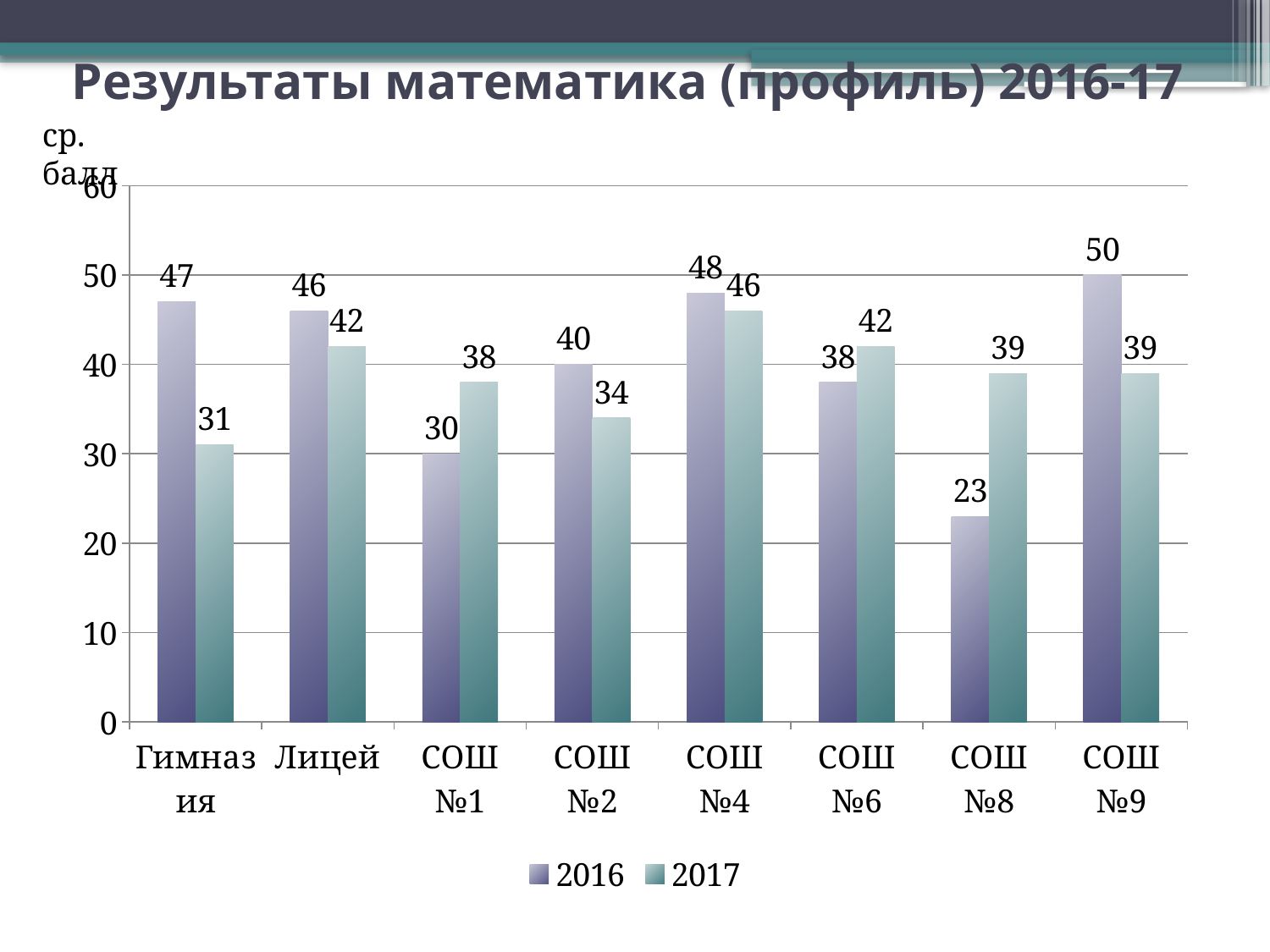
What is the 2017 value for СОШ №8? 39 What is the 2016 value for Гимназия? 47 What kind of chart is shown on the slide? bar chart What is the 2017 value for Лицей? 42 What is the title of the chart? Результаты математика (профиль) 2016-17 What is the difference between the 2016 and 2017 values for Гимназия? 16 Which category has the lowest 2017 value? Гимназия Which is larger for СОШ №1: the 2016 value or the 2017 value? 2017 Which category has the lowest 2016 value? СОШ №8 Which category has the highest 2016 value? СОШ №9 How many categories are shown on the x axis? 8 How many series does the legend list? 2